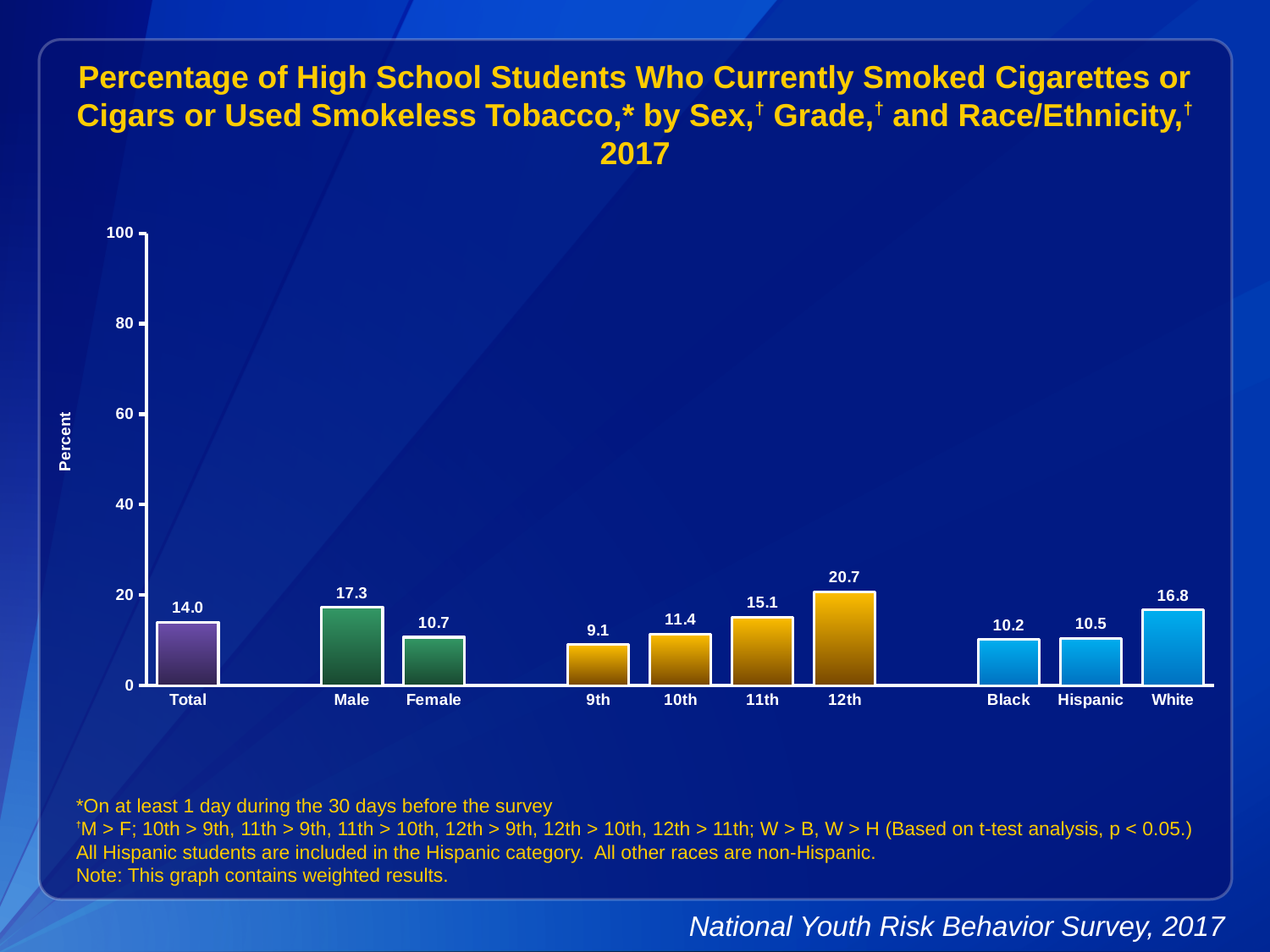
What is the difference between the Male and Female values? 6.6 What is the value for Hispanic students? 10.5 Which is larger, the value for Black or the value for White? White What is the value for 12th grade? 20.7 What is the value for Male? 17.3 Which category has the highest value? 12th Is the value for 12th grade greater or less than 20? greater Do the values rise or fall from 9th grade to 12th grade? rise How many categories are shown on the x axis? 10 Which category has the lowest value? 9th What kind of chart is this? bar chart What is the value for Total? 14.0